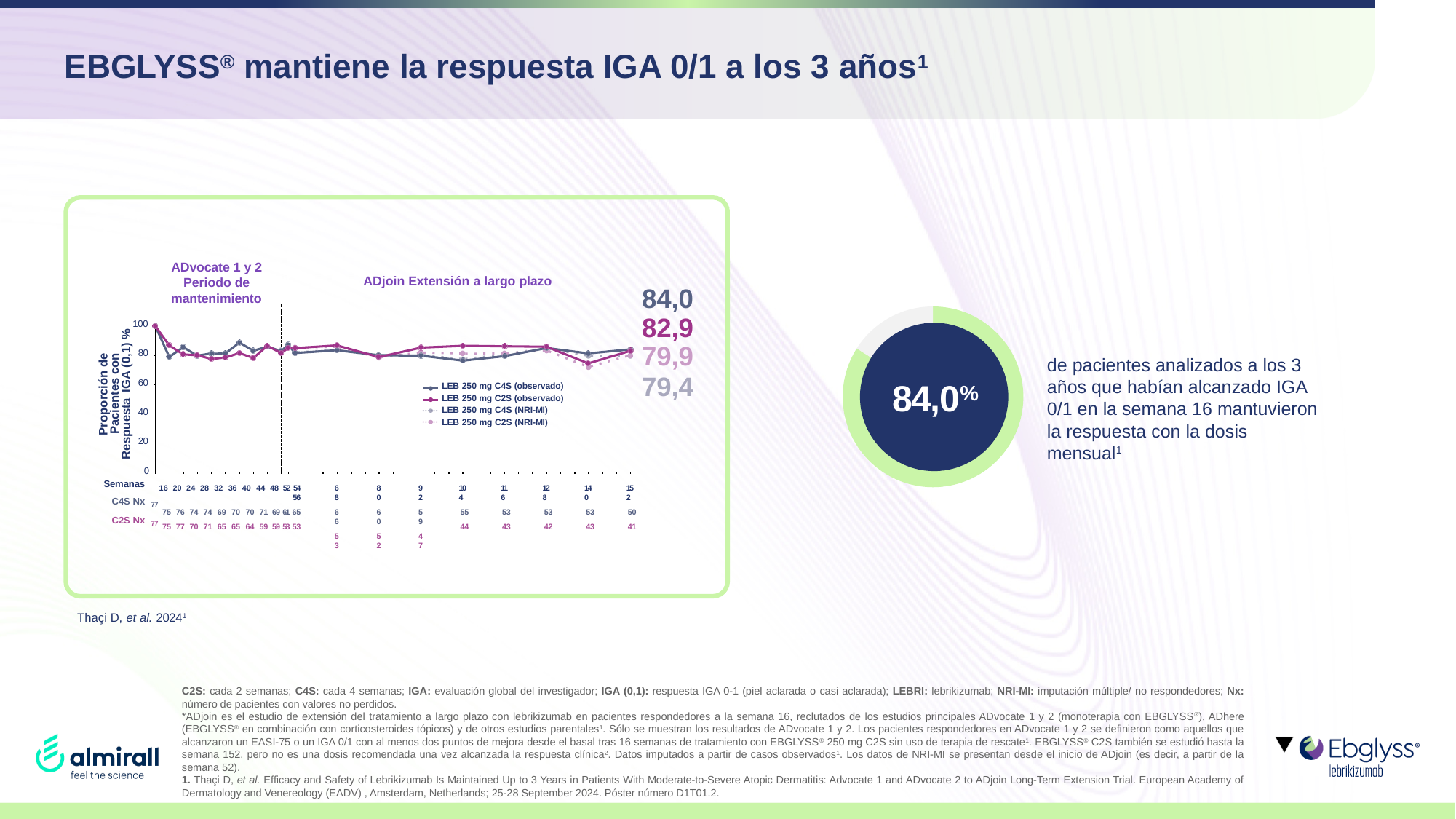
In the line chart, what is the highest value printed at the right end of the lines (week 152)? 84,0 In the line chart, are the values at week 152 greater or less than 60? greater In the line chart, what is the difference between the highest and lowest end values printed at week 152 (84,0 and 79,4)? 4,6 What kind of chart is shown inside the green-bordered box on the left of the slide? Line chart What percentage is shown in the centre of the donut chart on the right of the slide? 84,0% In the line chart, what is the C4S Nx value at week 152? 50 In the line chart, what is the lowest value printed at the right end of the lines (week 152)? 79,4 In the line chart, how many series does the legend list? 4 In the line chart, what is the title of the y axis? Proporción de Pacientes con Respuesta IGA (0,1) % In the line chart, which end value is larger: 82,9 or 79,9? 82,9 In the line chart, what is the C2S Nx value at week 152? 41 In the line chart, what is the C4S Nx value at week 16? 77